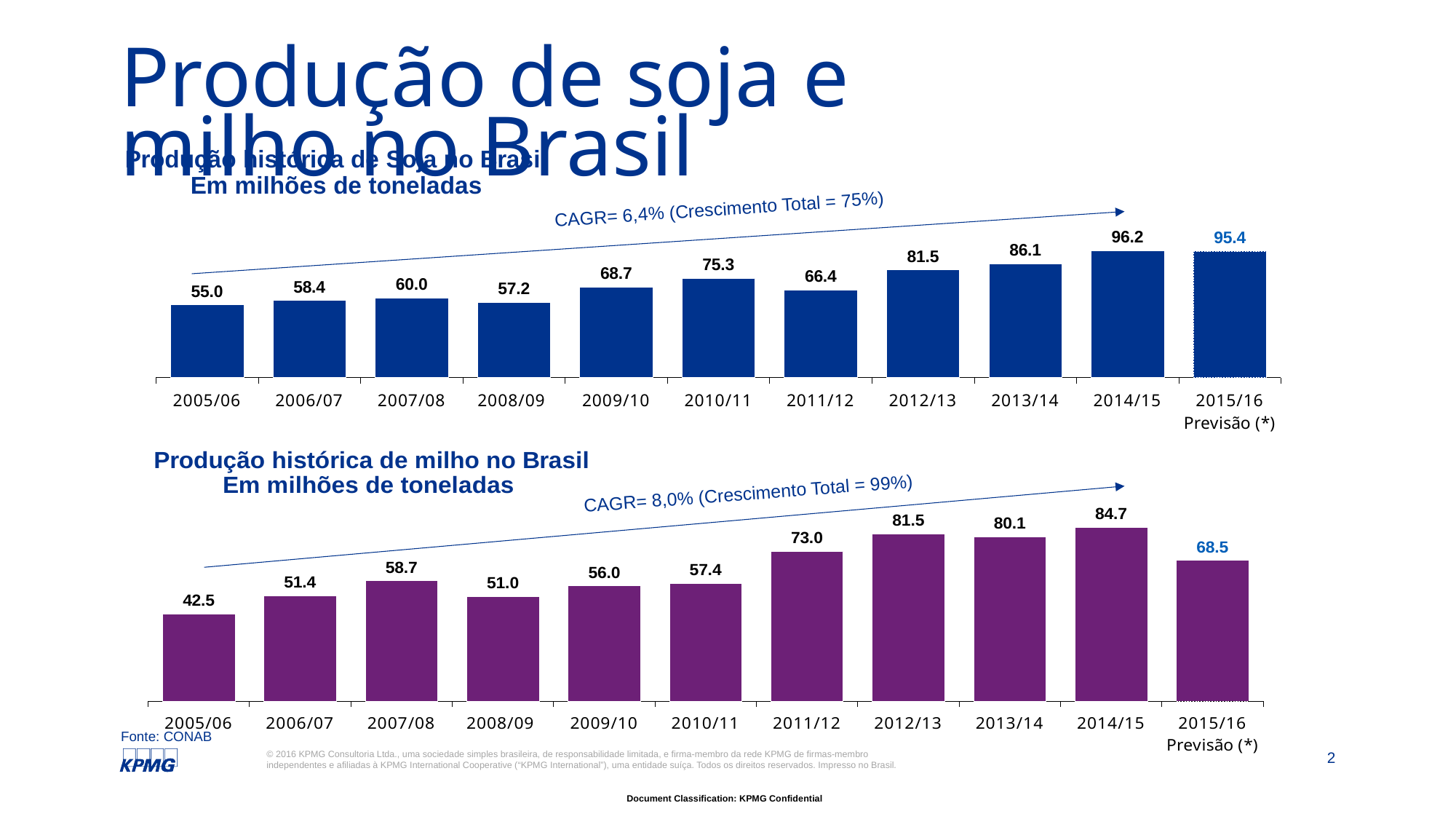
In the bottom chart (corn production), which is larger: the value for 2012/13 or the value for 2013/14? 2012/13 In the top chart (soy production), what is the difference between the 2014/15 value and the 2005/06 value? 41.2 In the top chart (soy production), which year has the highest value? 2014/15 In the bottom chart (corn production), do the values generally rise or fall from 2005/06 to 2014/15? Rise In the top chart (soy production), which is larger: the value for 2011/12 or the value for 2010/11? 2010/11 In the bottom chart (corn production), which year has the lowest value? 2005/06 What CAGR is stated on the top chart (soy production)? 6,4% In the top chart (soy production), what is the value for 2010/11? 75.3 In the bottom chart (corn production), what is the value for 2011/12? 73.0 How many years (bars) are shown in the top chart (soy production)? 11 In the bottom chart (corn production), what is the difference between the 2014/15 value and the 2015/16 forecast value? 16.2 What kind of chart is the bottom chart (corn production)? Bar chart